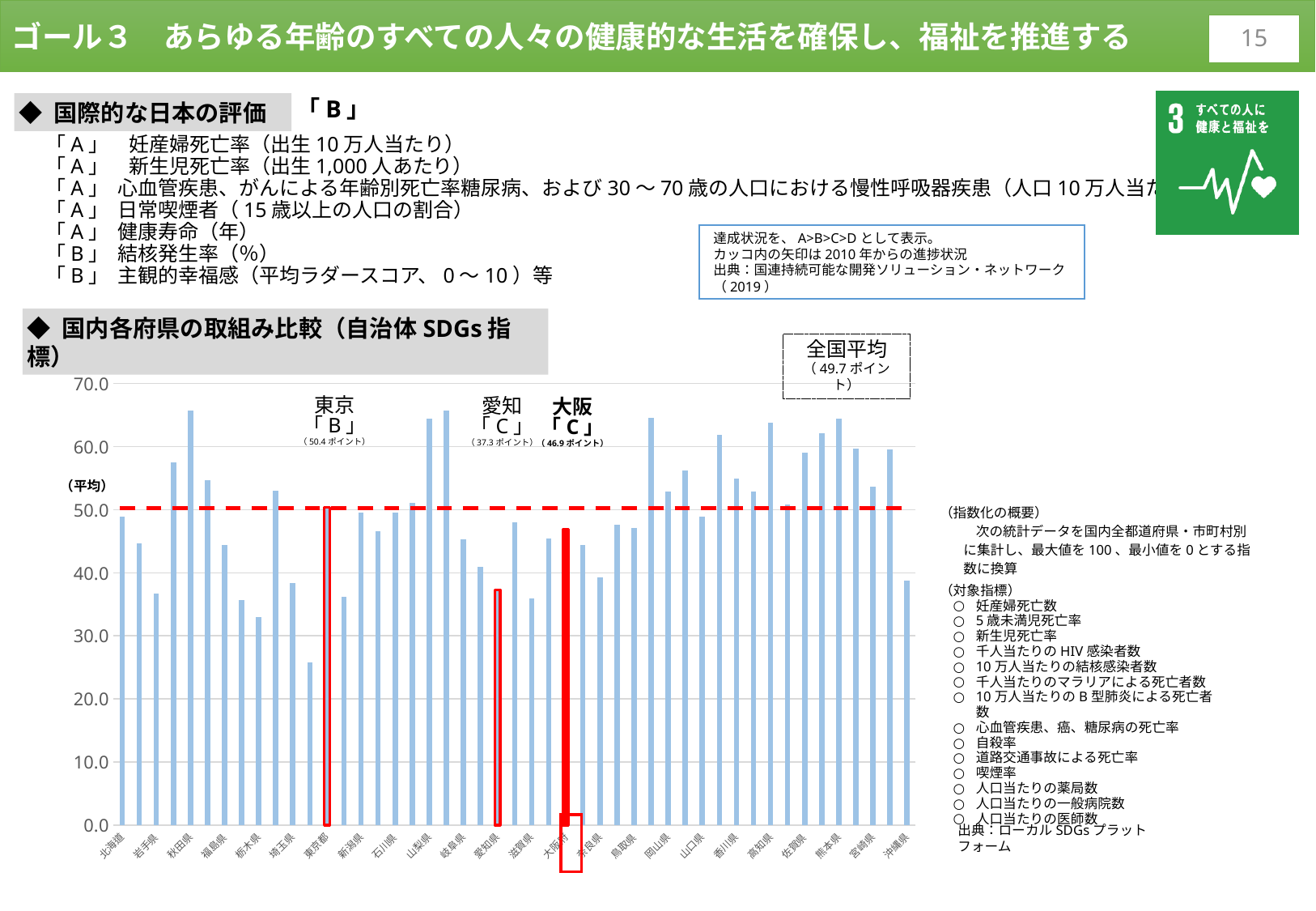
Is the value for 栃木県 greater or less than 40.0? less Which has the larger value, 東京 or 大阪? 東京 What is the value shown for 大阪 (Osaka) on the chart? 46.9 ポイント Is the value for 大阪 above or below the 全国平均 (national average)? below What is the difference between the values for 東京 and 大阪? 3.5 ポイント Is the value for 秋田県 greater or less than 60.0? greater What is the value shown for 愛知 (Aichi) on the chart? 37.3 ポイント What does the red dashed horizontal line on the chart represent? 全国平均 (49.7 ポイント) What is the difference between the values for 大阪 and 愛知? 9.6 ポイント What is the 全国平均 (national average) value indicated on the chart? 49.7 ポイント What is the value shown for 東京 (Tokyo) on the chart? 50.4 ポイント What kind of chart is shown on the slide? bar chart